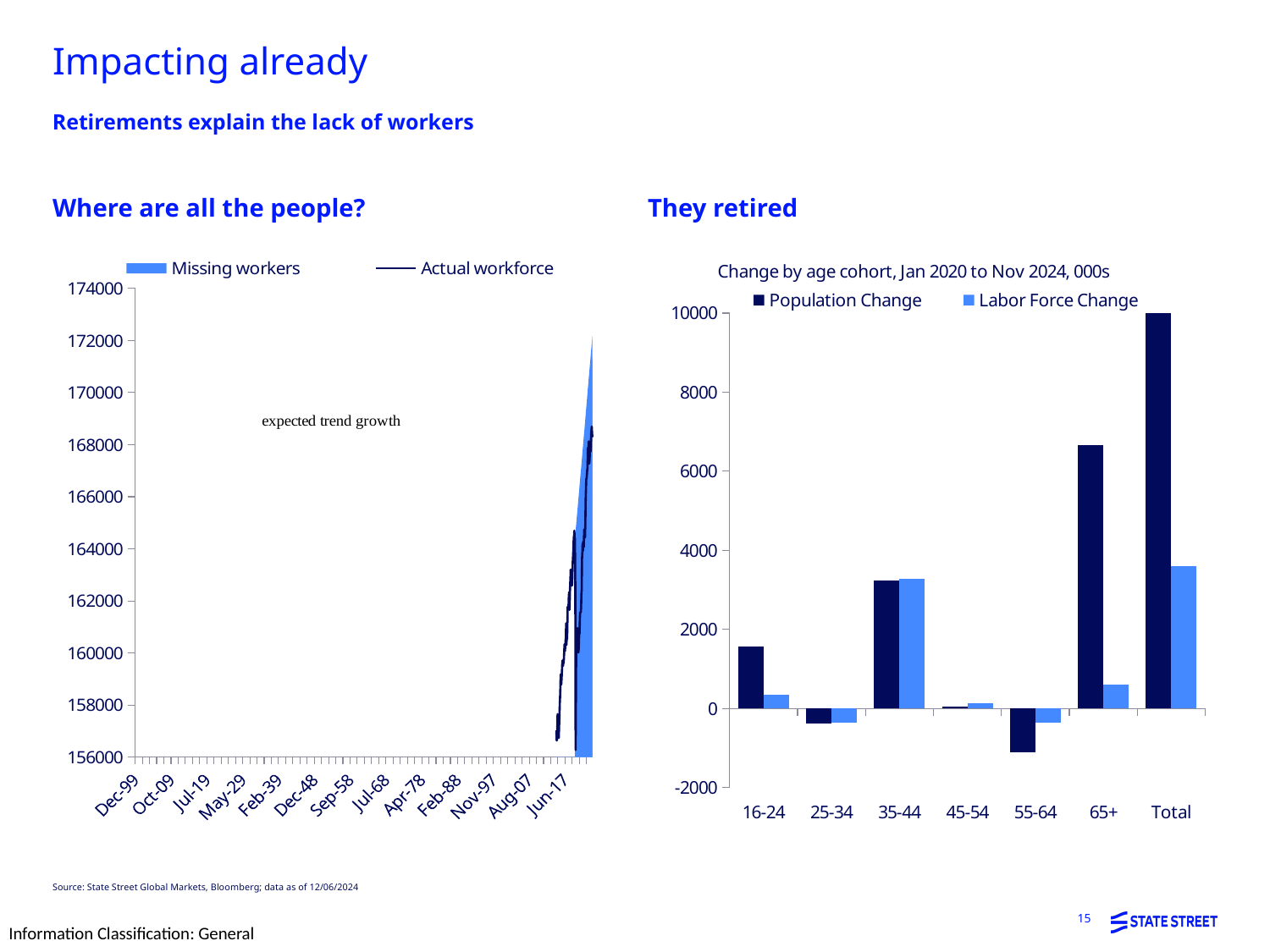
On the 'They retired' chart, is the Population Change for 16-24 greater or less than 2000? less On the 'They retired' chart, how many age cohort categories (including Total) are shown on the x axis? 7 On the 'They retired' chart, which category has the highest Population Change? Total On the 'They retired' chart, is the Population Change for 65+ greater or less than 6000? greater On the 'They retired' chart, which age cohort (excluding Total) has the highest Labor Force Change? 35-44 On the 'They retired' chart, which category has the lowest Population Change? 55-64 On the 'They retired' chart, how many series does the legend list? 2 On the 'Where are all the people?' chart, how many series does the legend list? 2 On the 'They retired' chart, is the Labor Force Change for Total greater or less than 4000? less What kind of chart is the 'They retired' chart? Bar chart On the 'They retired' chart, which age cohort (excluding Total) has the highest Population Change? 65+ On the 'They retired' chart, for the 65+ cohort, which is larger: Population Change or Labor Force Change? Population Change